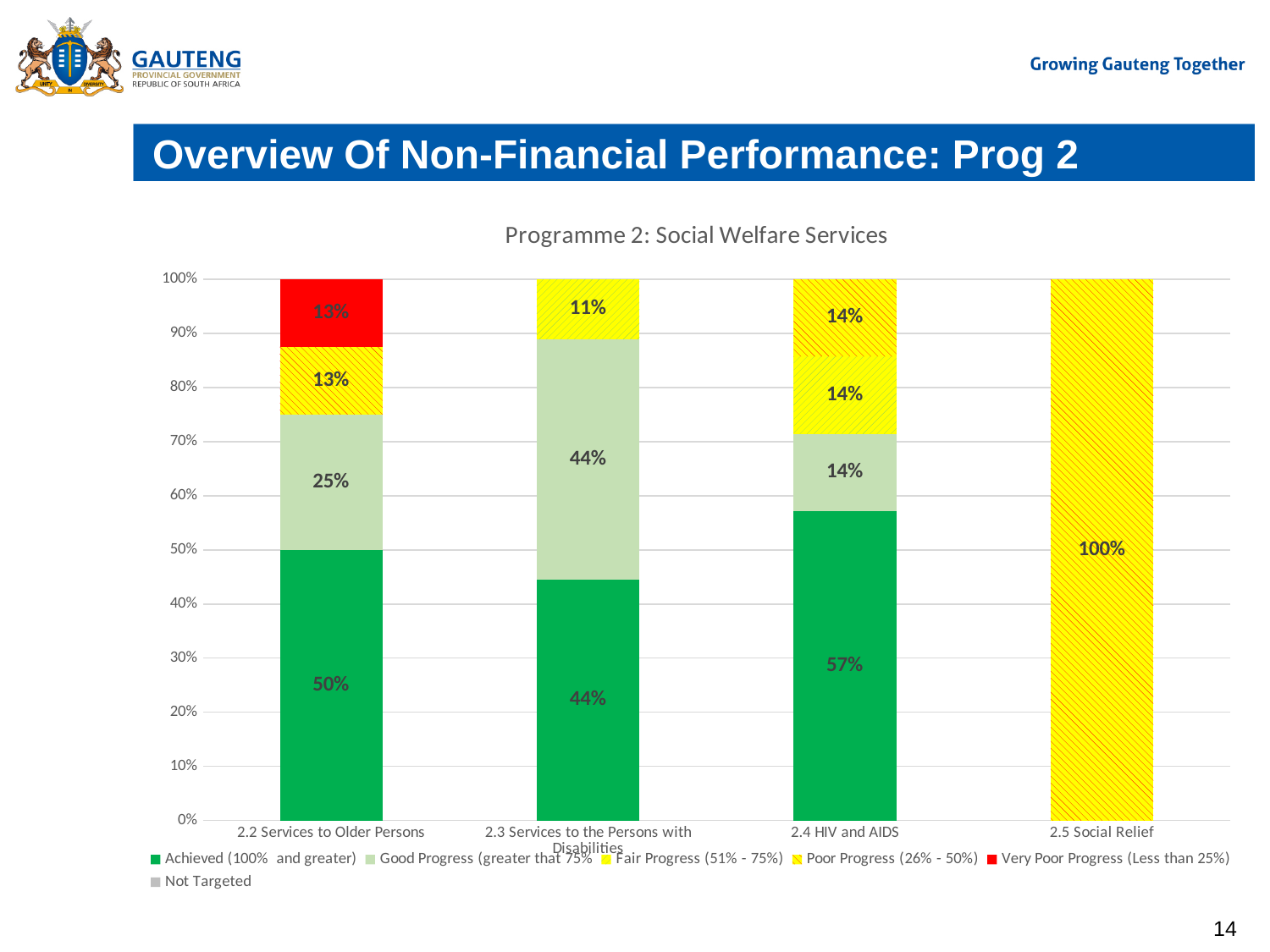
Which category has the largest Achieved (100% and greater) share? 2.4 HIV and AIDS What is the Achieved (100% and greater) share for 2.4 HIV and AIDS? 57% How many categories are shown on the x axis of the chart? 4 What is the Very Poor Progress (Less than 25%) share for 2.2 Services to Older Persons? 13% What is the title of the chart? Programme 2: Social Welfare Services What kind of chart is shown on the slide? Stacked bar chart What is the difference in percentage points between the Achieved share for 2.4 HIV and AIDS and the Achieved share for 2.2 Services to Older Persons? 7 percentage points What is the Good Progress (greater that 75%) share for 2.3 Services to the Persons with Disabilities? 44% Which has the larger Achieved (100% and greater) share, 2.2 Services to Older Persons or 2.3 Services to the Persons with Disabilities? 2.2 Services to Older Persons How many series does the chart's legend list? 6 Which category is the only one with a Very Poor Progress (Less than 25%) segment? 2.2 Services to Older Persons What is the Poor Progress (26% - 50%) share for 2.5 Social Relief? 100%